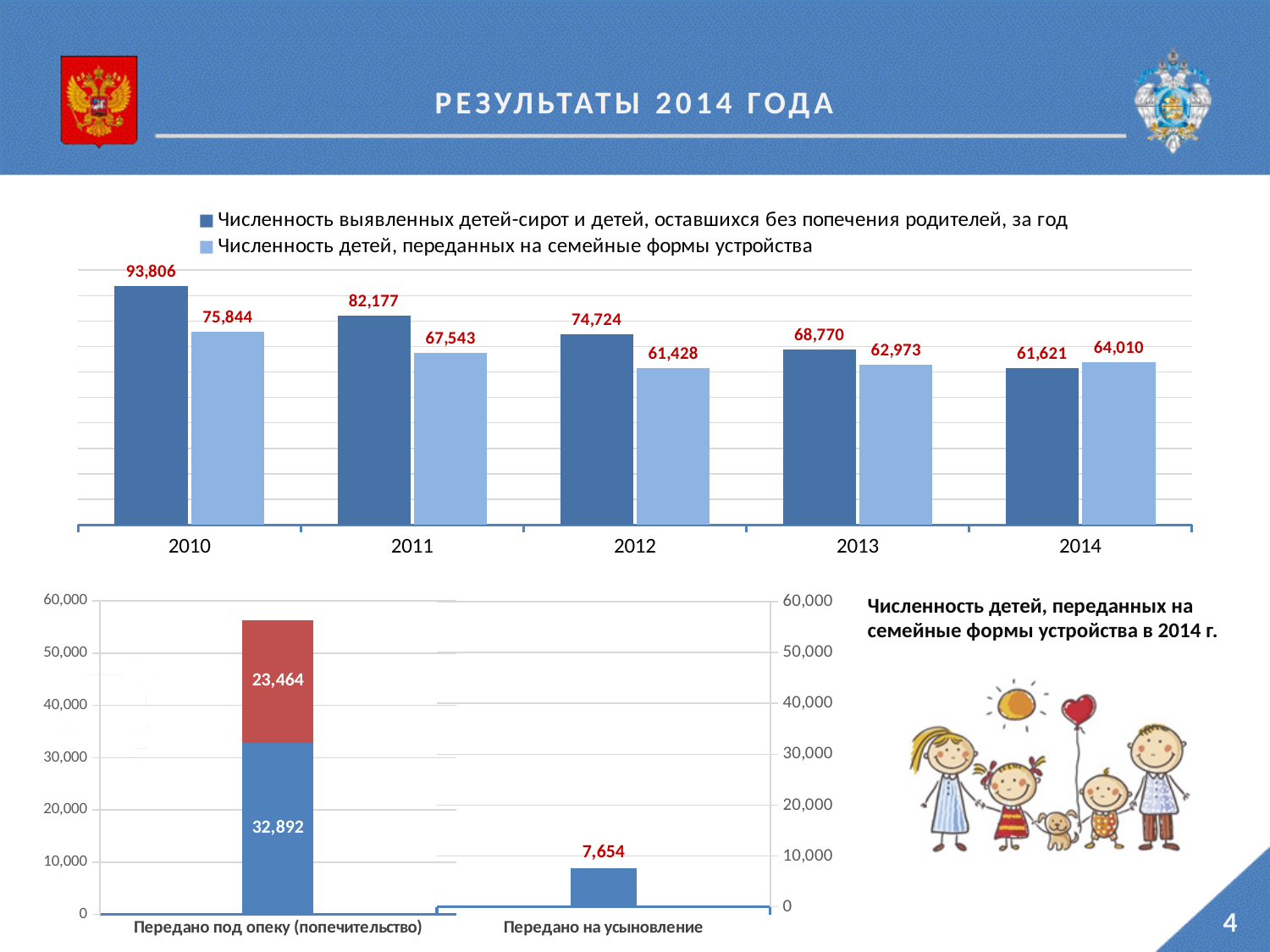
How many series does the legend of the top chart list? 2 In the top chart, for 2014, which is larger: the number of identified children or the number placed in family forms of care? The number placed in family forms of care (64,010) In the top chart, which year has the highest number of identified orphans and children left without parental care? 2010 How many years are shown on the x axis of the top chart? 5 In the top chart, what is the number of identified orphans and children left without parental care (Численность выявленных детей-сирот) in 2010? 93,806 In the top chart, what is the number of children placed in family forms of care (Численность детей, переданных на семейные формы устройства) in 2014? 64,010 In the top chart, what is the difference between the number of identified children and the number placed in family care in 2010? 17,962 In the top chart, does the number of identified orphans and children left without parental care rise or fall from 2010 to 2014? Fall What kind of chart is the bottom chart on the slide? Stacked bar chart In the top chart, which year has the lowest number of identified orphans and children left without parental care? 2014 In the bottom chart, what is the value for 'Передано на усыновление'? 7,654 In the bottom chart, what is the total of the stacked bar for 'Передано под опеку (попечительство)'? 56,356